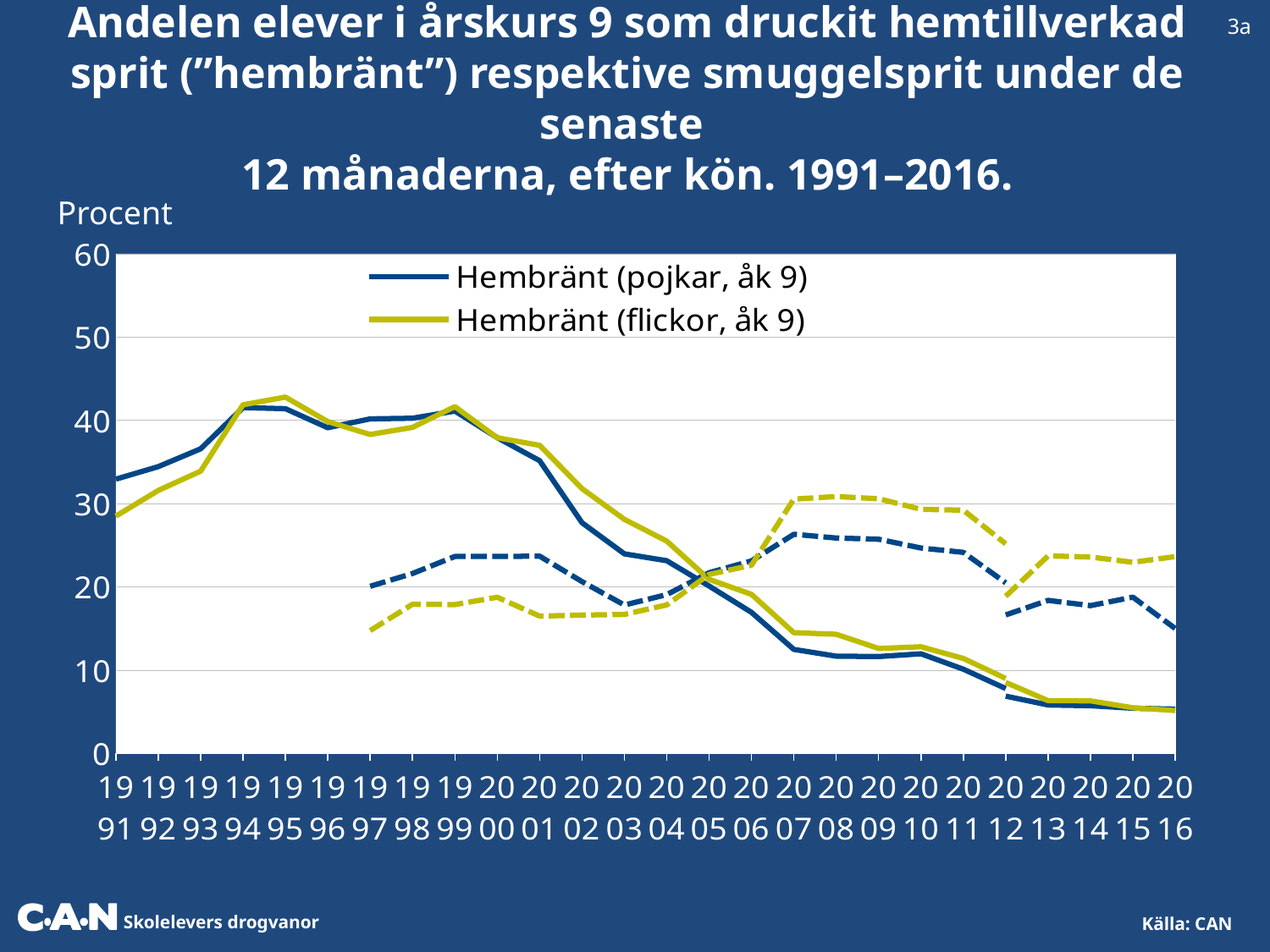
How many years are shown on the x axis? 26 Does the value for Hembränt (pojkar, åk 9) rise or fall between 2001 and 2016? Fall How many series does the legend list? 2 Is the value for Hembränt (flickor, åk 9) in 2007 greater or less than 20? less Which colour is used for the series 'Hembränt (pojkar, åk 9)'? Dark blue Is the value for Hembränt (pojkar, åk 9) in 2016 greater or less than 10? less Is the value for Hembränt (flickor, åk 9) in 1995 greater or less than 40? greater What is the label on the y axis? Procent In which year does Hembränt (flickor, åk 9) reach its highest value? 1995 In 1991, which series has the higher value: Hembränt (pojkar, åk 9) or Hembränt (flickor, åk 9)? Hembränt (pojkar, åk 9) What kind of chart is shown on the slide? Line chart